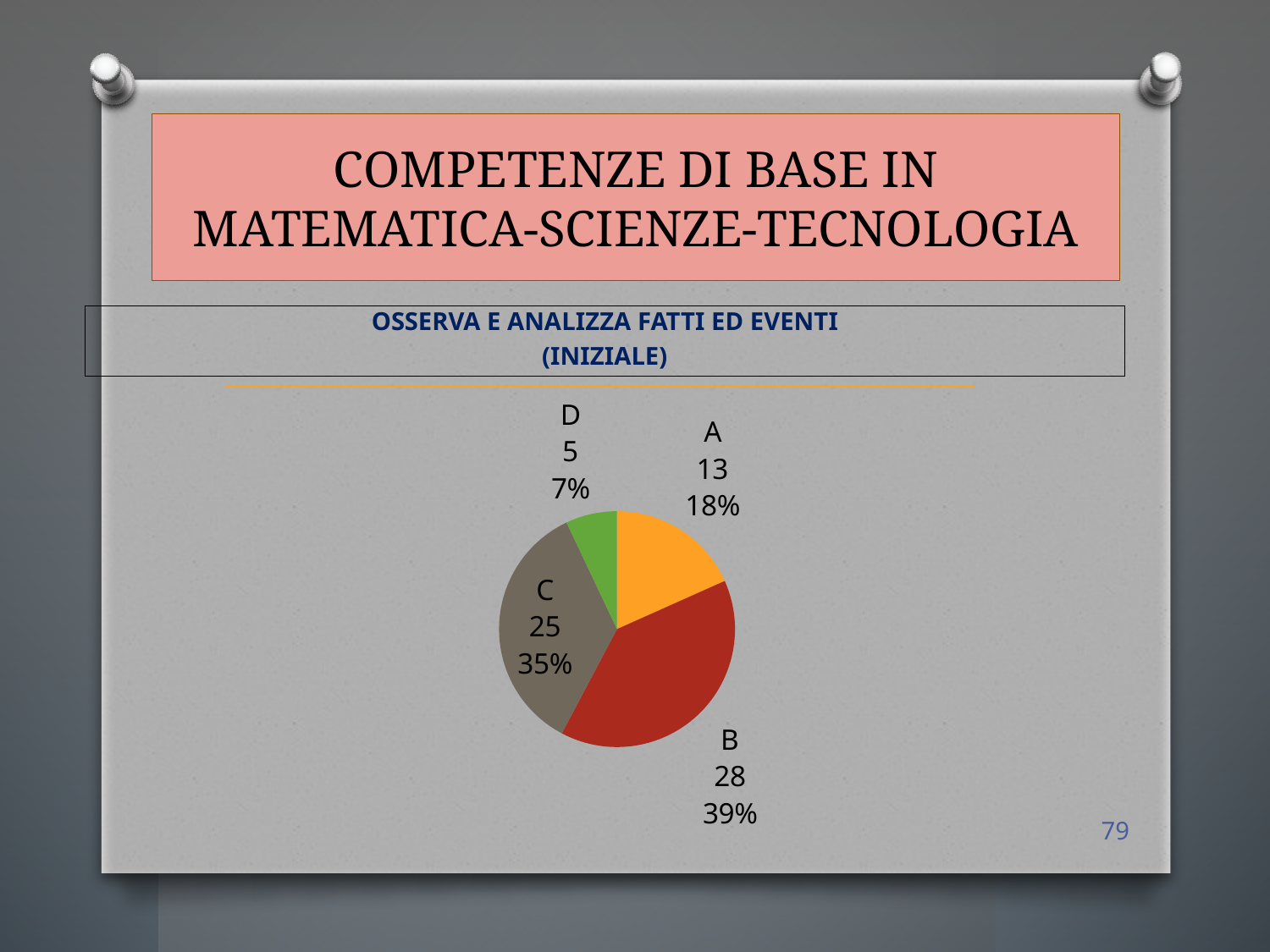
Which is larger, the value for A or the value for C? C Which category has the smallest slice? D What percentage share does category C have? 35% What is the value for category B? 28 What is the difference between the values for B and C? 3 What is the total of all the values in the pie chart? 71 What colour is the slice for category D? green What kind of chart is shown on the slide? pie chart What is the value for category D? 5 How many categories are shown in the pie chart? 4 Which category has the largest slice? B What percentage share does category A have? 18%